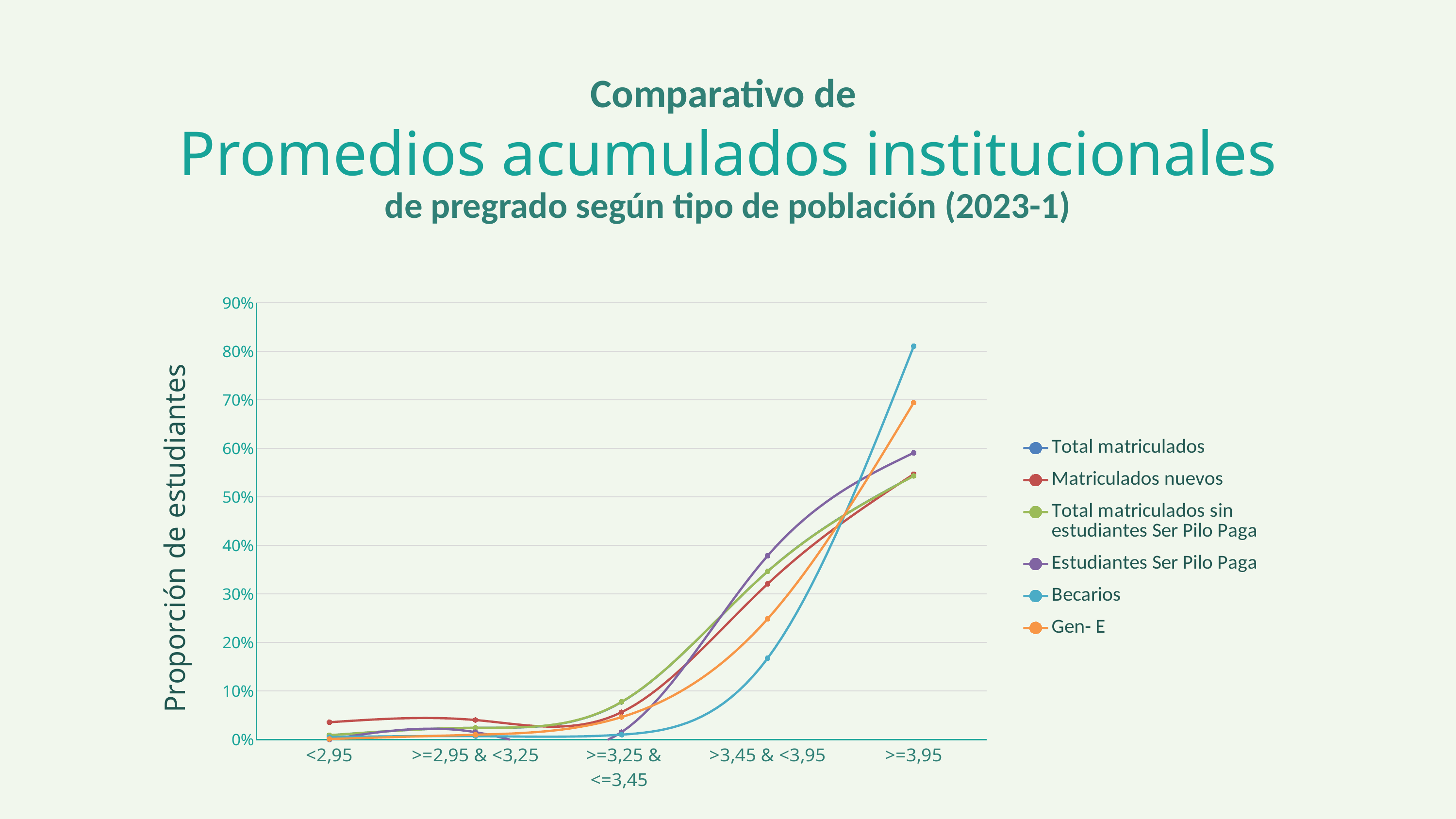
Which series has the lowest value in the >3,45 & <3,95 category? Becarios Is the value for Becarios in the >=3,95 category greater or less than 70%? greater Is the value for Becarios in the >3,45 & <3,95 category greater or less than 20%? less In the >=3,95 category, which is larger: Becarios or Gen- E? Becarios How many categories are shown on the x axis? 5 Is the value for Matriculados nuevos in the <2,95 category greater or less than 10%? less Which series has the highest value in the >=3,95 category? Becarios How many series does the legend list? 6 What is the title of the vertical axis? Proporción de estudiantes Does the Becarios line rise or fall from the >=3,25 & <=3,45 category to the >=3,95 category? rise What kind of chart is shown on the slide? Line chart